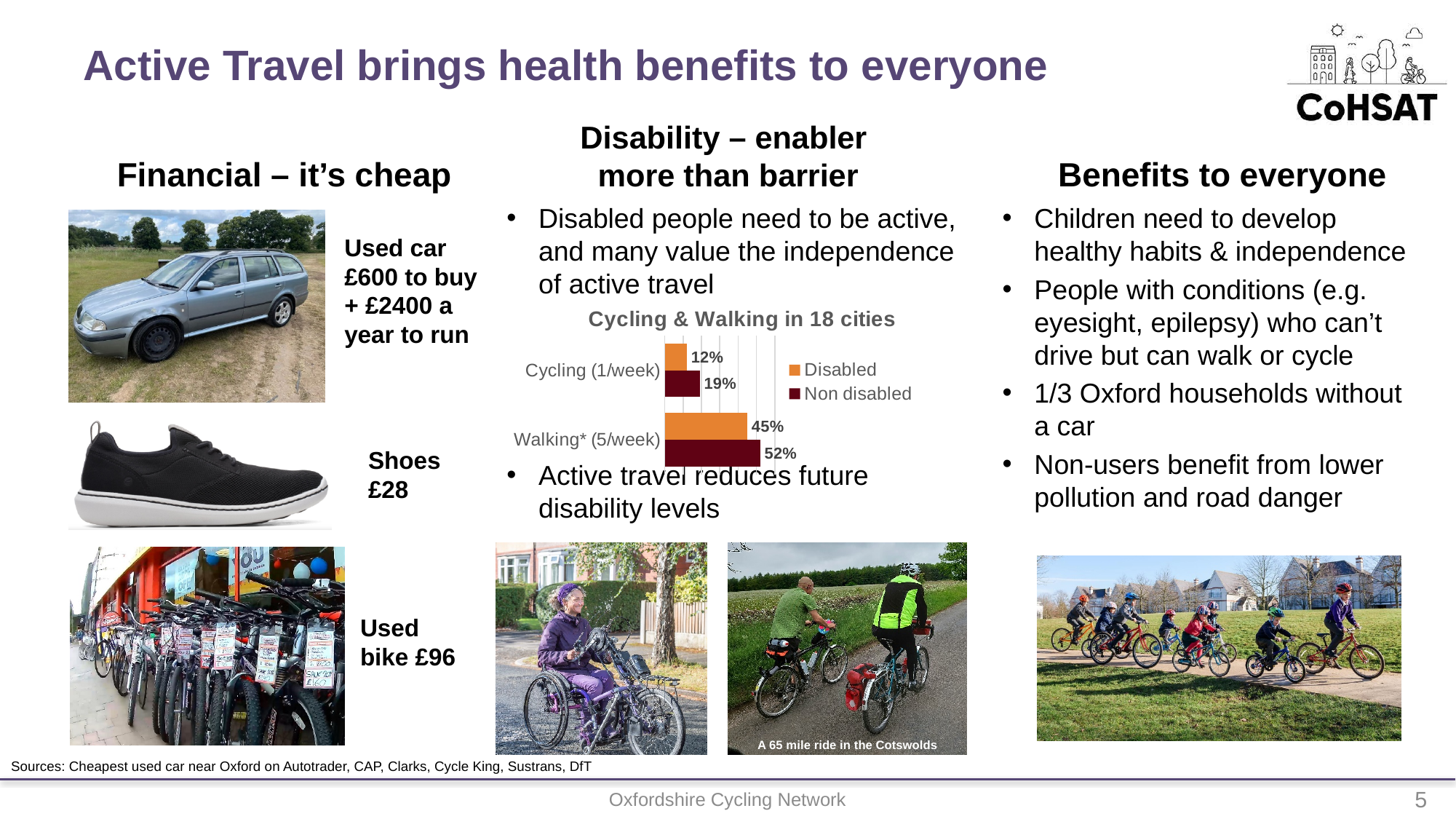
What is the value for Disabled people for Walking* (5/week)? 45% Which series is shown in orange on the chart? Disabled Which category has the highest value for Non disabled people? Walking* (5/week) What is the difference between the Non disabled and Disabled values for Cycling (1/week)? 7% What is the value for Disabled people for Cycling (1/week)? 12% What is the value for Non disabled people for Cycling (1/week)? 19% What kind of chart is shown on the slide? bar chart How many series does the chart's legend list? 2 What is the title of the chart on the slide? Cycling & Walking in 18 cities How many categories are shown on the chart? 2 What is the value for Non disabled people for Walking* (5/week)? 52% What is the difference between the Non disabled and Disabled values for Walking* (5/week)? 7%